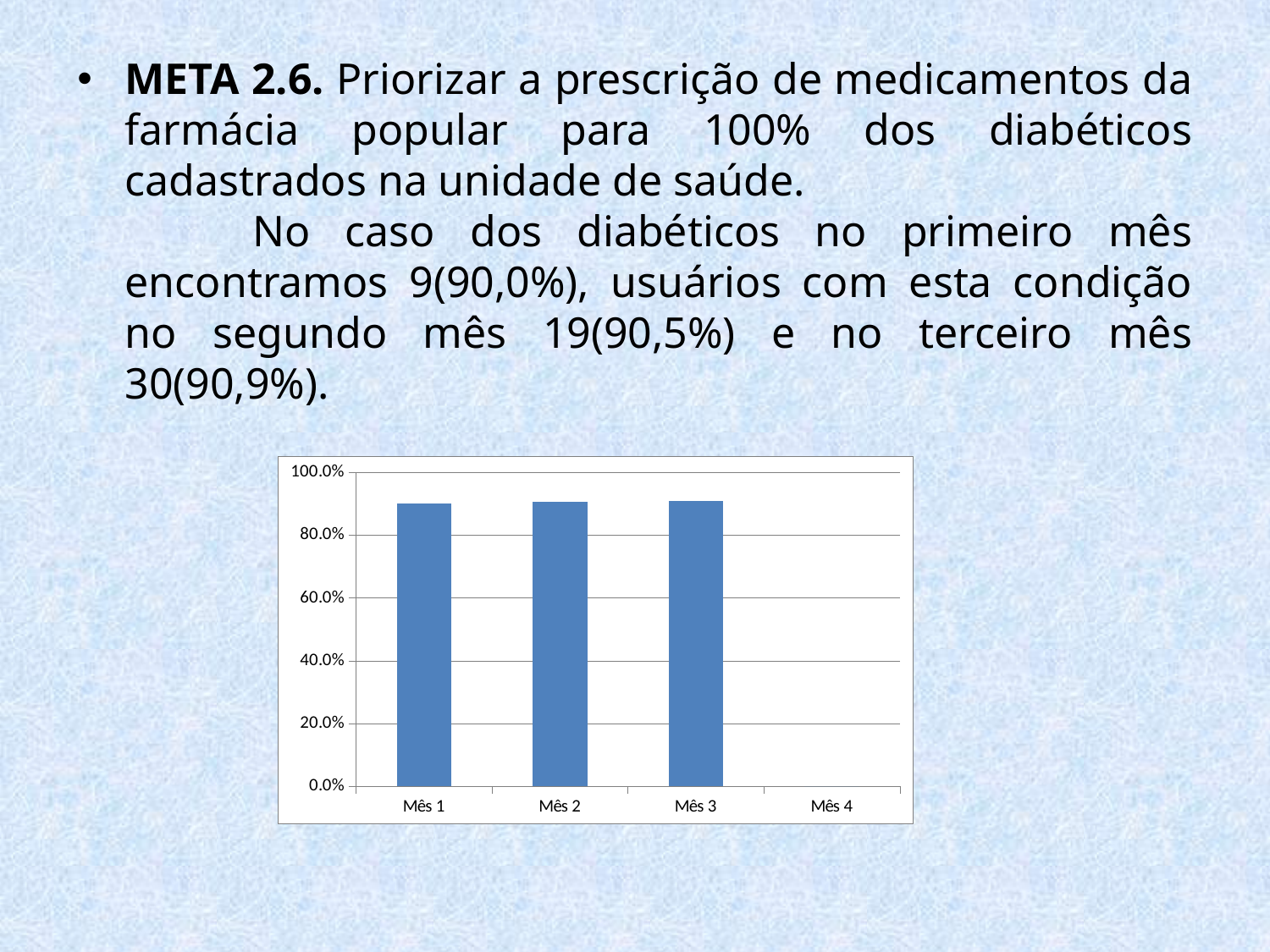
Is the value for Mês 3 greater or less than 60.0%? greater How many categories are labelled on the x axis of the chart? 4 Which category on the x axis has no bar shown? Mês 4 Is the value for Mês 1 greater or less than 80.0%? greater What is the label of the first category on the x axis? Mês 1 How many bars are visible in the chart? 3 What kind of chart is shown on the slide? bar chart What is the highest value shown on the y axis of the chart? 100.0% Which is larger, the bar for Mês 1 or the bar for Mês 4? Mês 1 Is the value for Mês 2 greater or less than 100.0%? less